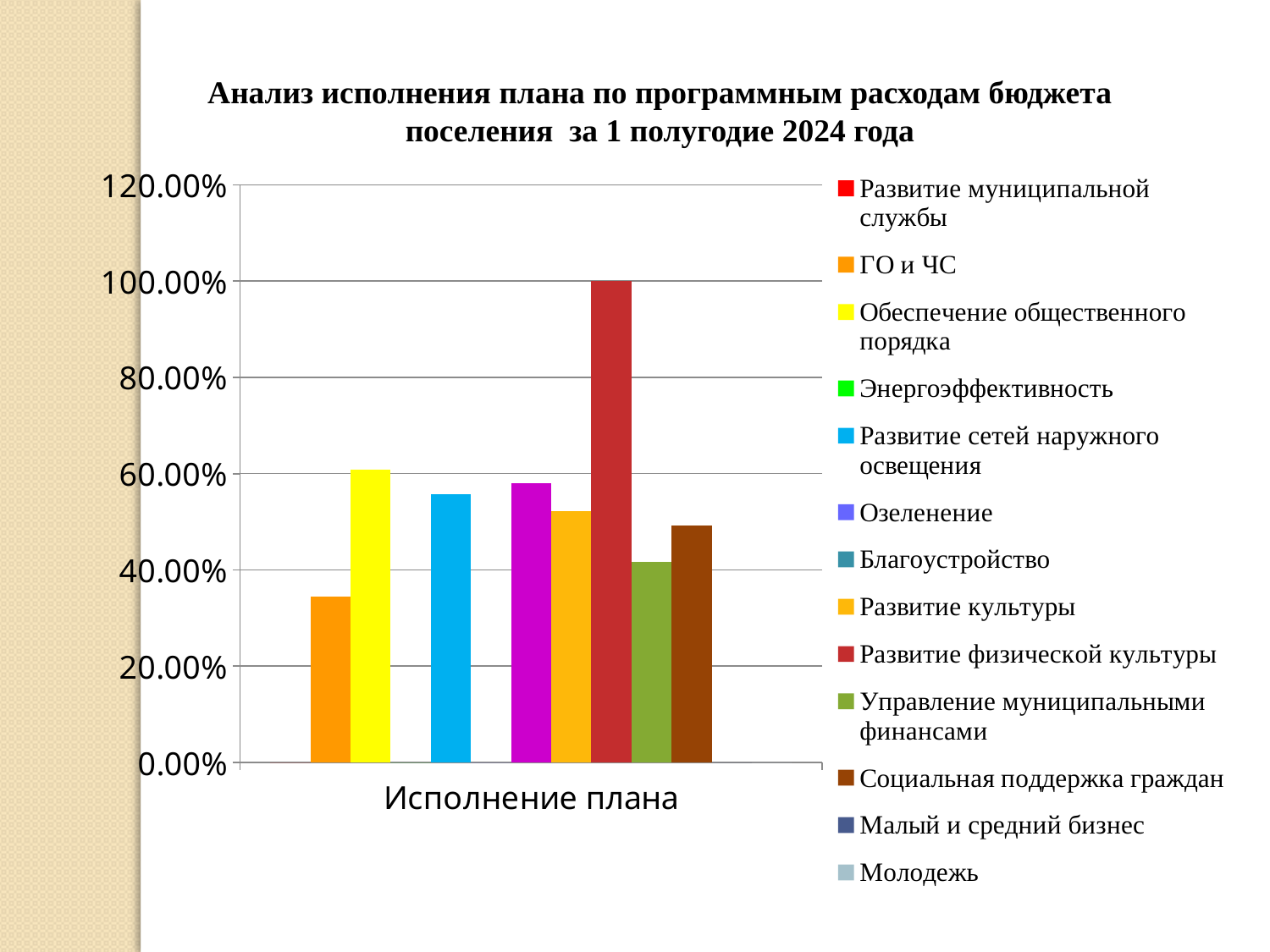
Which series has the tallest bar? Развитие физической культуры What kind of chart is shown on the slide? bar chart What is the label of the single category on the x axis? Исполнение плана What is the value for Развитие физической культуры? 100.00% Is the value for ГО и ЧС greater or less than 40.00%? less Is the value for Развитие сетей наружного освещения greater or less than 40.00%? greater Is the value for Обеспечение общественного порядка greater or less than 80.00%? less Which is larger, the value for Обеспечение общественного порядка or the value for ГО и ЧС? Обеспечение общественного порядка How many categories are shown on the x axis? 1 How many series does the legend list? 13 Which is larger, the value for Развитие культуры or the value for Управление муниципальными финансами? Развитие культуры